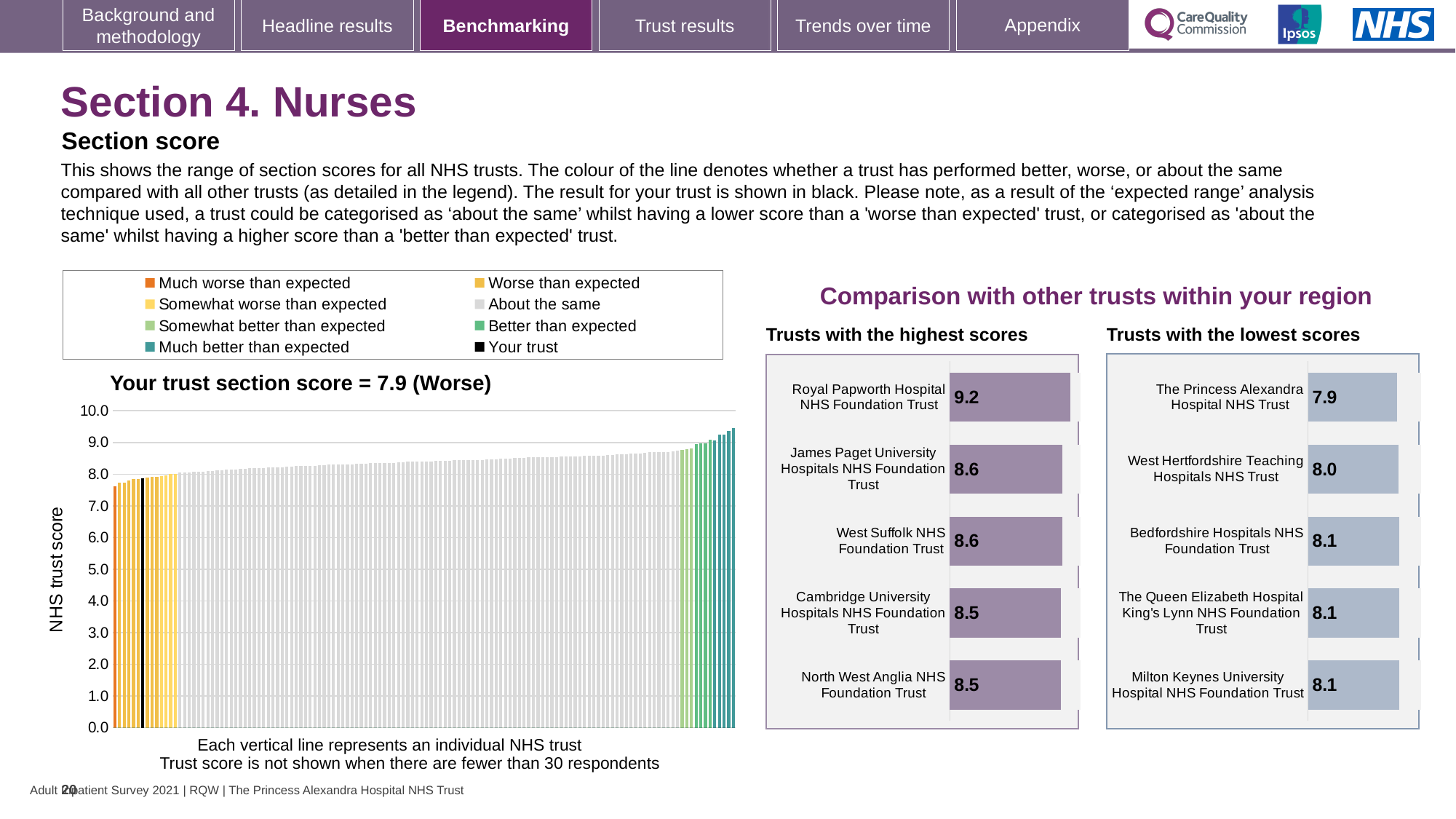
In the large chart on the left, do the trust scores rise or fall from left to right? Rise What kind of chart is the large chart on the left showing NHS trust scores? Bar chart In the 'Trusts with the lowest scores' chart, which trust has the lowest score? The Princess Alexandra Hospital NHS Trust How many entries does the legend above the large chart on the left list? 8 How many trusts are listed in the 'Trusts with the highest scores' chart? 5 In the 'Trusts with the highest scores' chart, what is the score for Royal Papworth Hospital NHS Foundation Trust? 9.2 According to the title of the large chart on the left, what is your trust's section score? 7.9 (Worse) In the 'Trusts with the lowest scores' chart, which has the larger score: West Hertfordshire Teaching Hospitals NHS Trust or Bedfordshire Hospitals NHS Foundation Trust? Bedfordshire Hospitals NHS Foundation Trust In the 'Trusts with the highest scores' chart, which trust has the highest score? Royal Papworth Hospital NHS Foundation Trust In the 'Trusts with the lowest scores' chart, what is the score for The Princess Alexandra Hospital NHS Trust? 7.9 In the 'Trusts with the lowest scores' chart, what is the difference between the scores of Milton Keynes University Hospital NHS Foundation Trust and The Princess Alexandra Hospital NHS Trust? 0.2 In the 'Trusts with the highest scores' chart, what is the difference between the scores of Royal Papworth Hospital NHS Foundation Trust and North West Anglia NHS Foundation Trust? 0.7